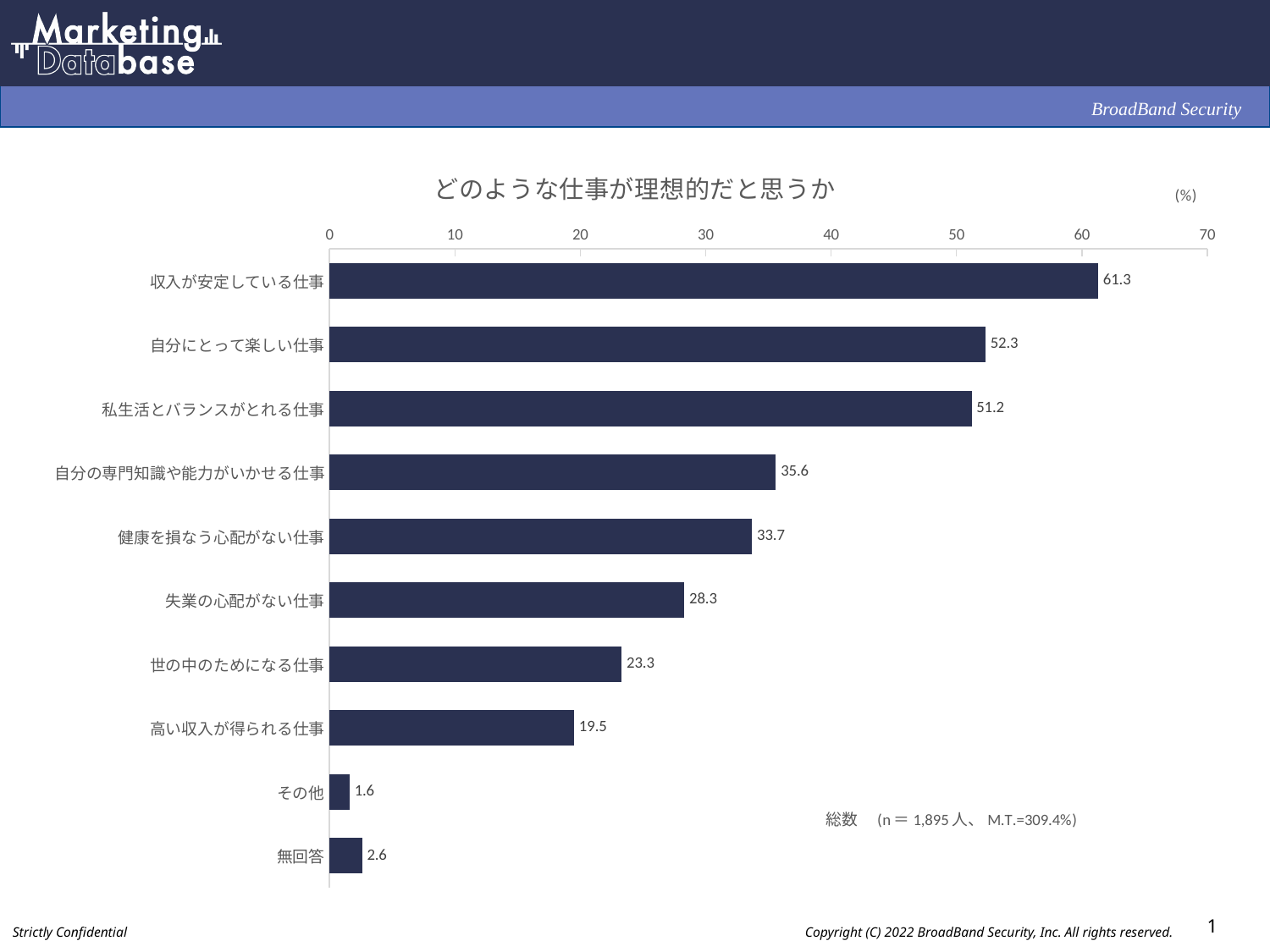
Which is larger, the value for 健康を損なう心配がない仕事 or 失業の心配がない仕事? 健康を損なう心配がない仕事 Which category has the lowest value? その他 What is the value for 高い収入が得られる仕事? 19.5 Is the value for 世の中のためになる仕事 greater or less than 30? less What is the difference between the values for 自分にとって楽しい仕事 and 私生活とバランスがとれる仕事? 1.1 What kind of chart is shown on the slide? bar chart How many categories are shown in the chart? 10 What is the sample size (n) shown on the slide? 1,895 What is the value for 自分の専門知識や能力がいかせる仕事? 35.6 Which category has the highest value? 収入が安定している仕事 What is the value for 収入が安定している仕事? 61.3 What is the title of the chart? どのような仕事が理想的だと思うか